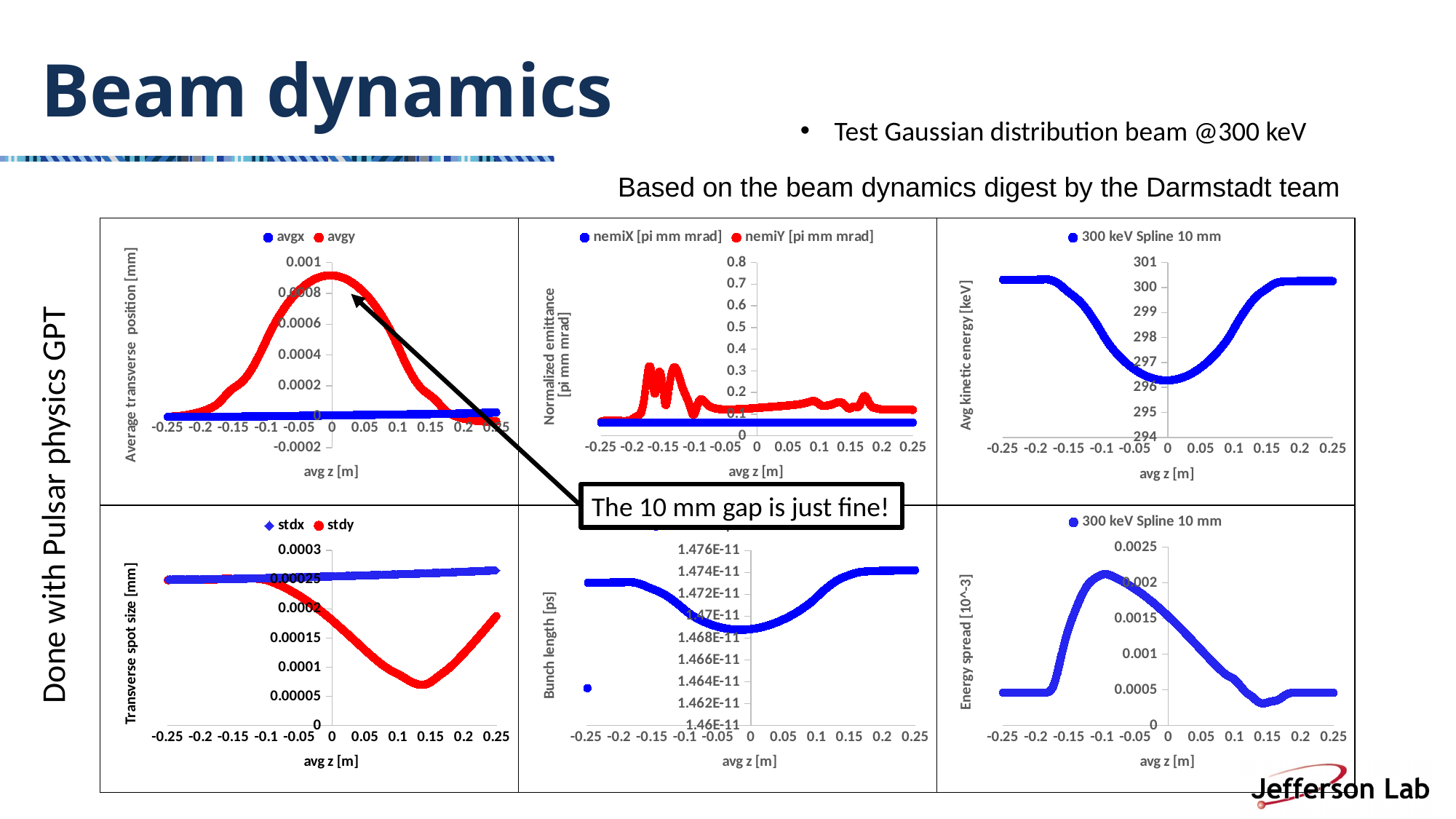
In the top-right chart (Avg kinetic energy), is the value at avg z = -0.25 greater or less than 300? greater What is the legend entry of the top-right chart (Avg kinetic energy)? 300 keV Spline 10 mm In the top-right chart (Avg kinetic energy), does the value rise or fall as avg z goes from -0.25 to 0? fall In the top-left chart (Average transverse position), is the avgy value at avg z = 0 greater or less than 0.0008? greater In the top-right chart (Avg kinetic energy), is the value at avg z = 0 greater or less than 297? less In the top-left chart (Average transverse position), which series has the larger value at avg z = 0, avgx or avgy? avgy How many series does the legend list in the top-left chart (Average transverse position)? 2 In the bottom-left chart (Transverse spot size), which series has the larger value at avg z = 0.15, stdx or stdy? stdx What are the legend entries of the top-middle chart (Normalized emittance)? nemiX [pi mm mrad] and nemiY [pi mm mrad]